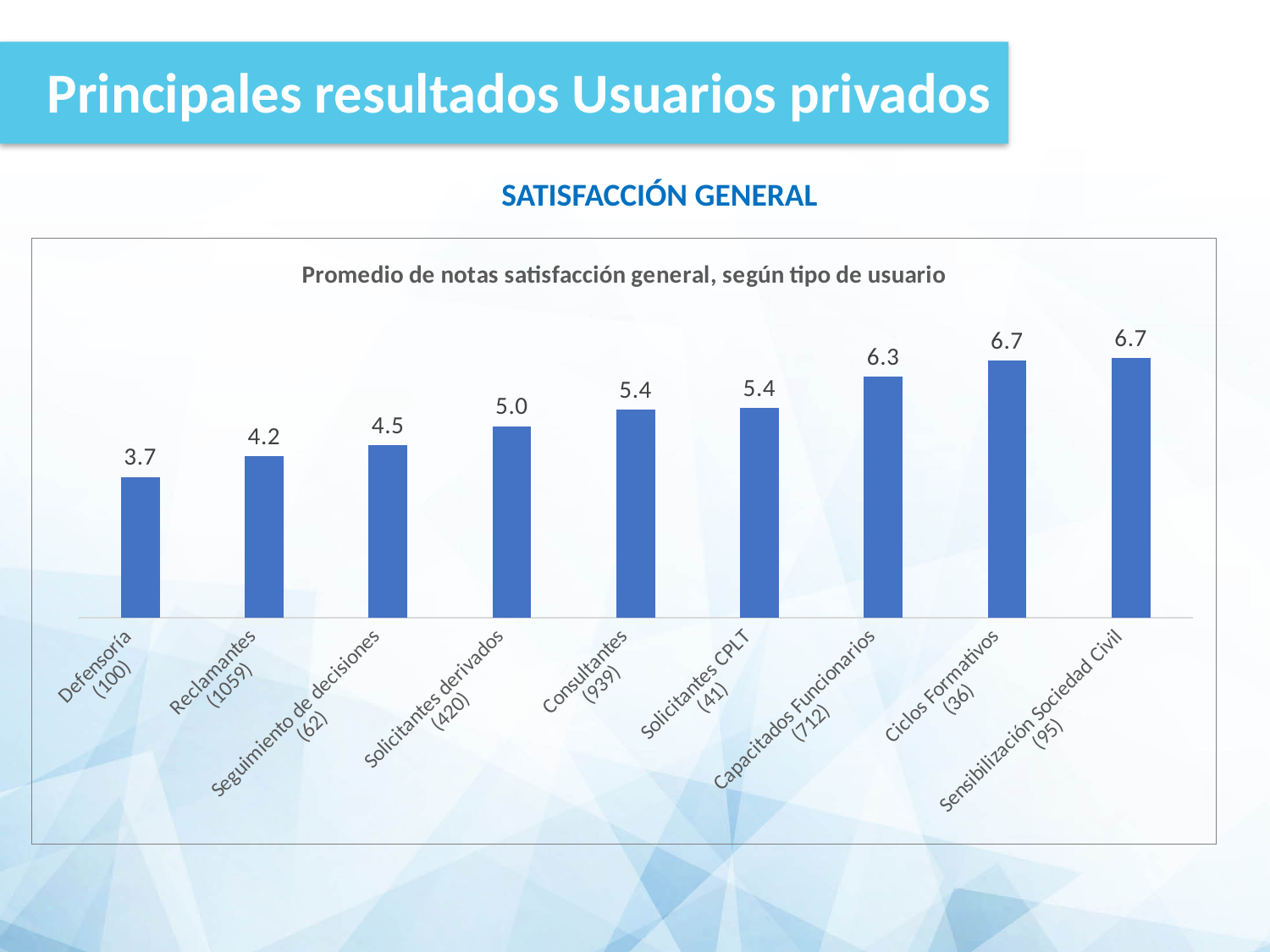
What is the difference between the scores for Capacitados Funcionarios (712) and Reclamantes (1059)? 2.1 What is the value shown for Capacitados Funcionarios (712)? 6.3 What kind of chart is shown on the slide? Bar chart Which user type has the lowest average general satisfaction score? Defensoría (100) Which has a higher score, Ciclos Formativos (36) or Capacitados Funcionarios (712)? Ciclos Formativos (36) Which has a higher score, Consultantes (939) or Reclamantes (1059)? Consultantes (939) How many user types are shown in the chart? 9 What is the value shown for Solicitantes derivados (420)? 5.0 What is the average general satisfaction score for Defensoría (100)? 3.7 What is the title of the chart? Promedio de notas satisfacción general, según tipo de usuario What is the value shown for Seguimiento de decisiones (62)? 4.5 What is the difference between the scores for Sensibilización Sociedad Civil (95) and Defensoría (100)? 3.0